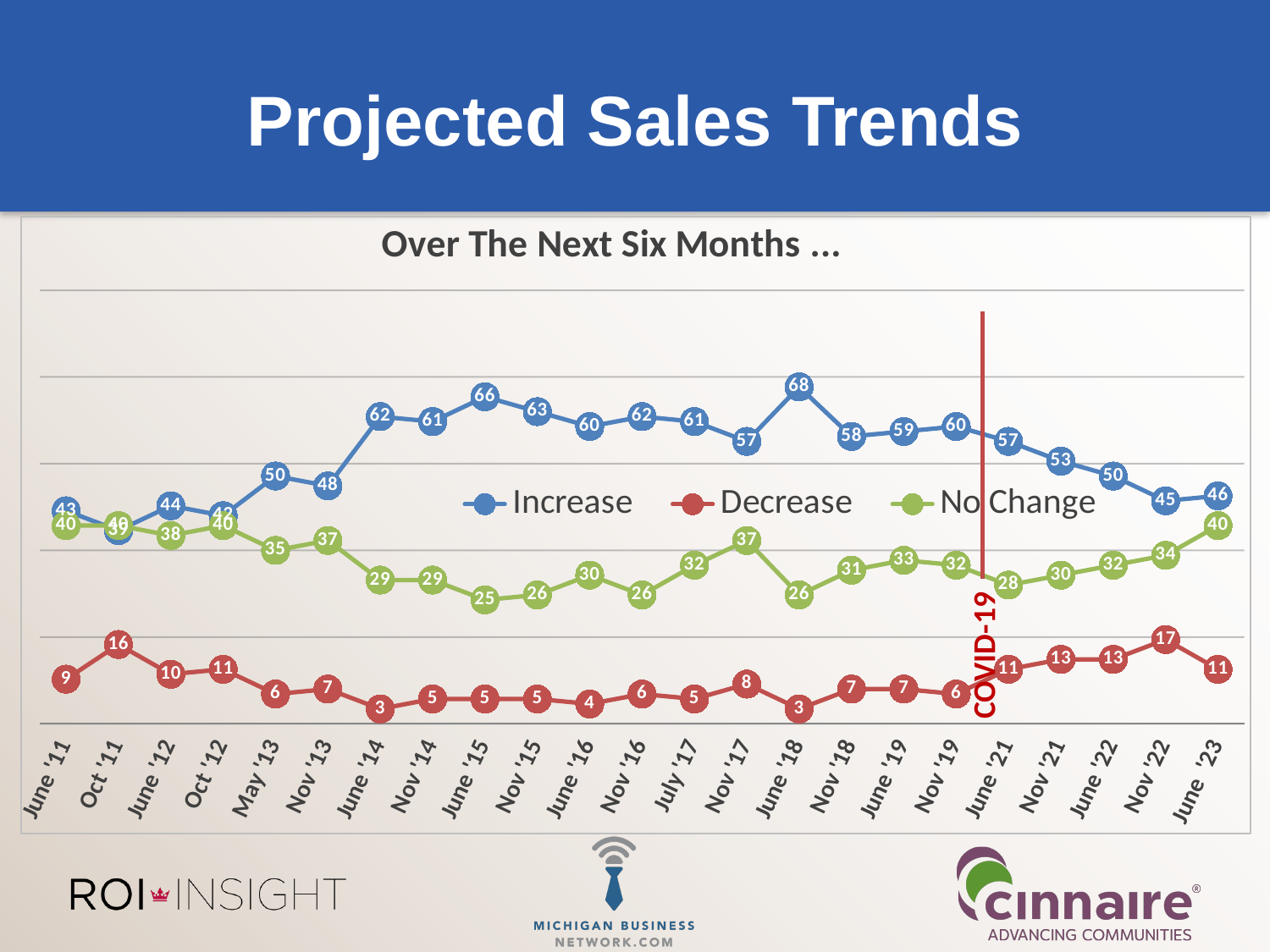
What label is written next to the red vertical line on the chart? COVID-19 At which date does the Increase series reach its highest value? June '18 Which is larger: the Decrease value at Oct '11 or at Nov '22? Nov '22 What is the value of the Increase series at June '23? 46 At which date is the No Change series at its lowest value? June '15 Does the Increase series rise or fall from June '18 to June '23? fall What kind of chart is shown on the slide? line chart How many series does the legend list? 3 What is the difference between the Increase value at June '18 and at June '23? 22 What is the value of the Decrease series at Nov '22? 17 How many dates are plotted along the x axis? 23 What is the value of the No Change series at June '23? 40